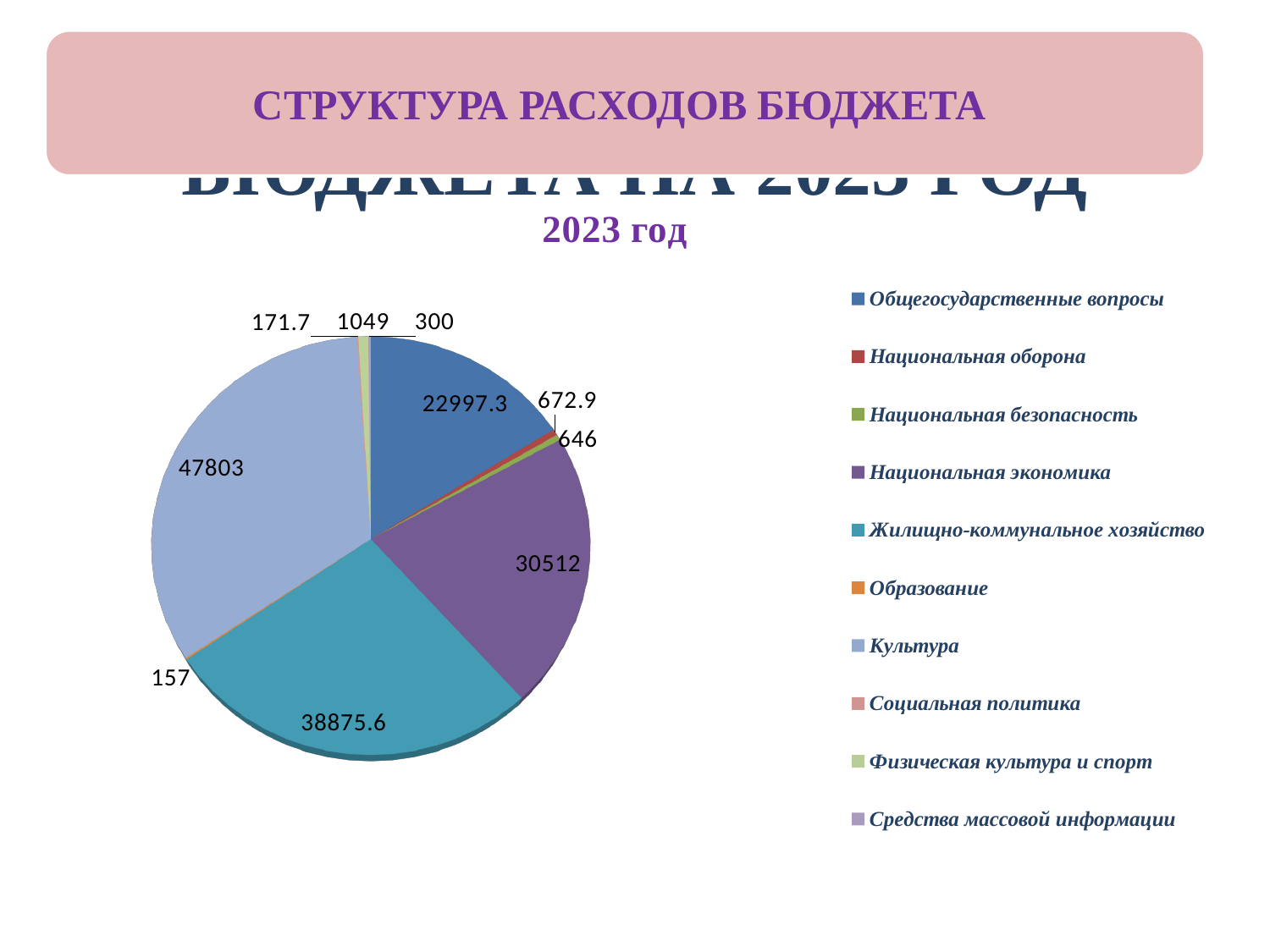
What is the value for Культура? 47803 How many categories does the legend list? 10 Which is larger, the value for Национальная экономика or the value for Жилищно-коммунальное хозяйство? Жилищно-коммунальное хозяйство Which category has the smallest value? Образование What is the value for Образование? 157 What is the value for Национальная оборона? 672.9 What is the difference between the values for Культура and Национальная экономика? 17291 What is the value for Жилищно-коммунальное хозяйство? 38875.6 What year is shown in the chart title? 2023 год What is the value for Общегосударственные вопросы? 22997.3 Which category has the largest slice of the pie? Культура What kind of chart is shown on the slide? pie chart